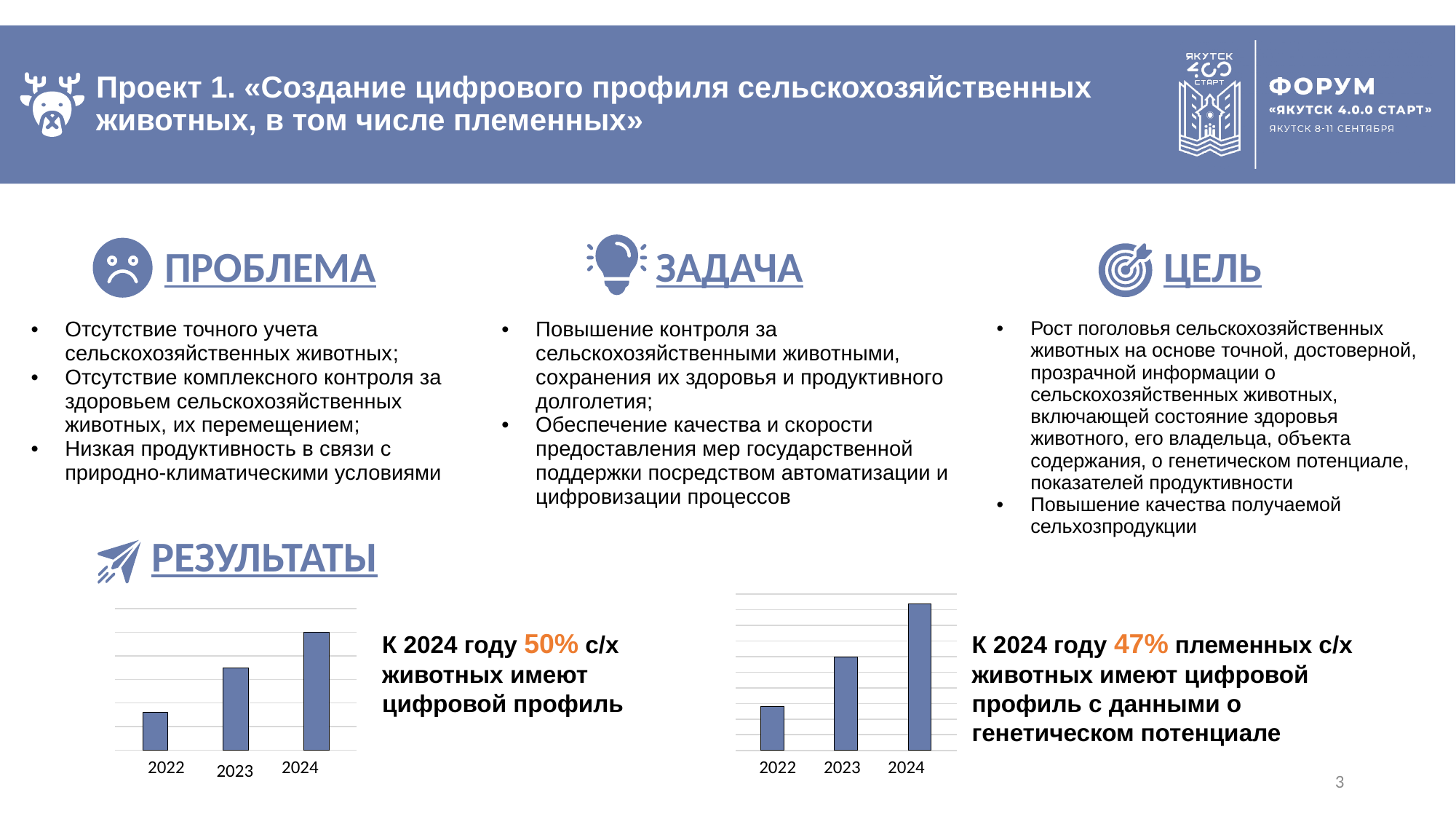
In the left chart, which year has the tallest bar? 2024 What are the category labels on the x axis of the right chart? 2022, 2023, 2024 How many categories are shown on the x axis of the left chart? 3 In the left chart, do the values rise or fall from 2022 to 2024? rise In the left chart, which year has the shortest bar? 2022 In the left chart, which is larger, the value for 2023 or the value for 2024? 2024 What kind of chart is the left chart under «РЕЗУЛЬТАТЫ»? bar chart How many bars does the right chart have? 3 In the right chart, is the bar for 2023 taller or shorter than the bar for 2022? taller What kind of chart is the right chart under «РЕЗУЛЬТАТЫ»? bar chart In the right chart, which year has the lowest value? 2022 In the right chart, which year has the highest value? 2024